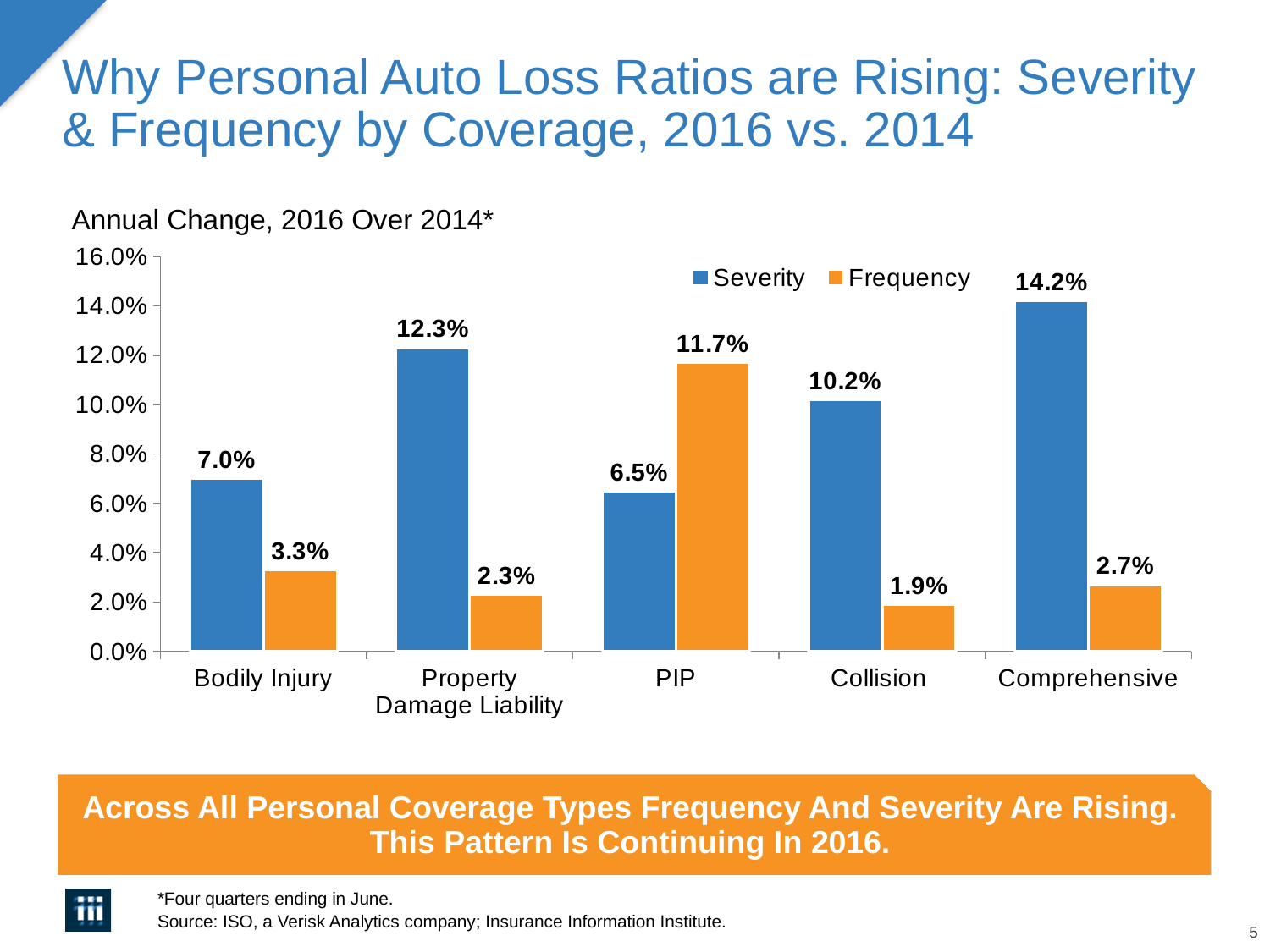
Which coverage has the lowest Frequency value? Collision What is the Frequency value for Collision? 1.9% What kind of chart is shown on the slide? Bar chart How many coverage categories are shown on the x axis? 5 What is the Severity value for Comprehensive? 14.2% What is the Severity value for Bodily Injury? 7.0% What is the difference between the Severity and Frequency values for Property Damage Liability? 10.0% What colour are the Frequency bars? Orange What is the Frequency value for PIP? 11.7% Which coverage has the highest Severity value? Comprehensive How many series does the legend list? 2 Which is larger for PIP, Severity or Frequency? Frequency